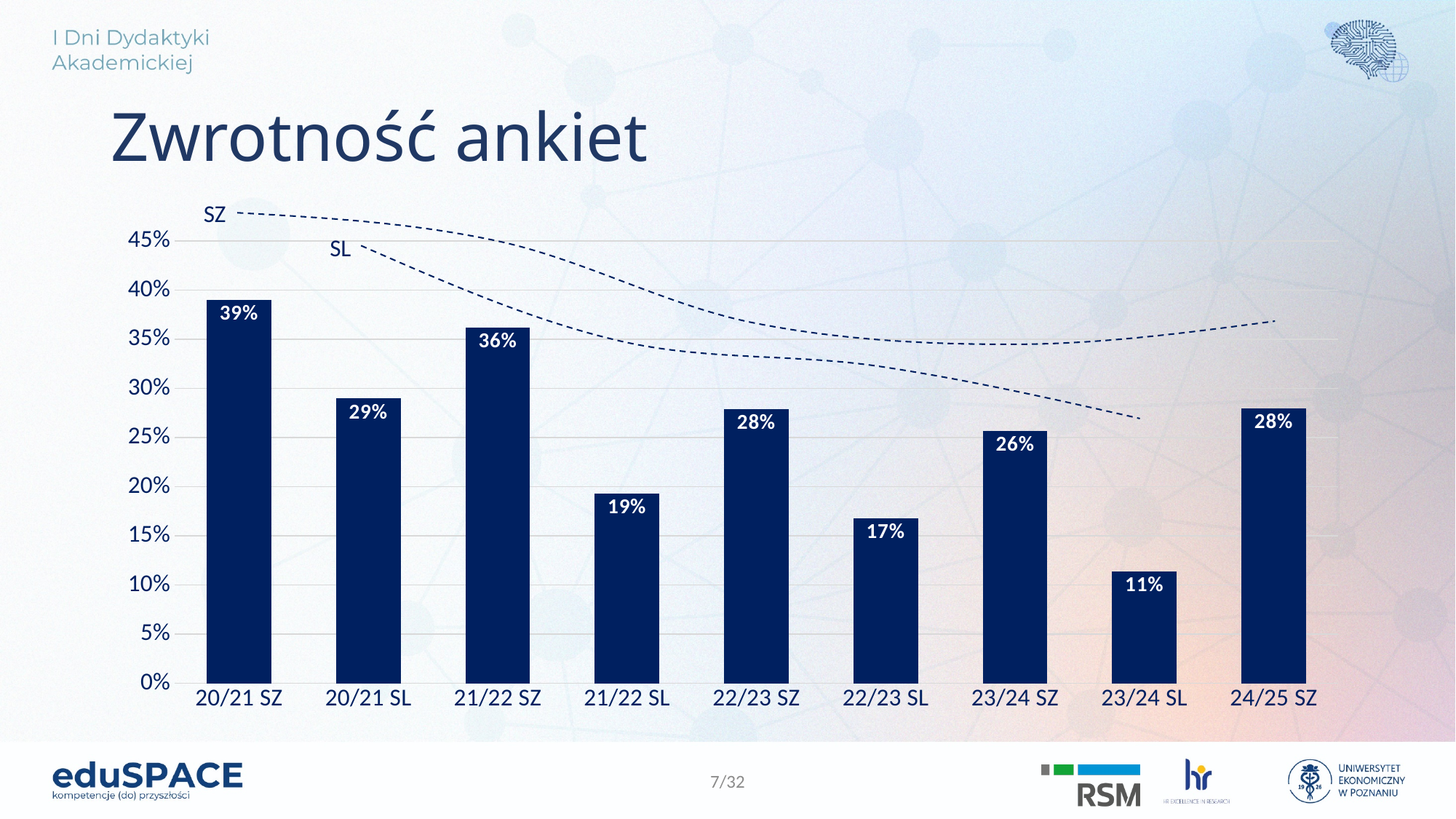
Do the values for the SZ categories rise or fall from 20/21 SZ to 23/24 SZ? fall What is the title of the chart? Zwrotność ankiet Which category has the lowest value? 23/24 SL Which category has the highest value? 20/21 SZ What is the value for 20/21 SZ? 39% How many categories are shown on the x axis? 9 Is the value for 22/23 SL greater or less than 20%? less What is the difference between the values for 21/22 SZ and 21/22 SL? 17% What is the value for 22/23 SZ? 28% What kind of chart is shown on the slide? bar chart What is the value for 23/24 SL? 11% Which is larger, the value for 20/21 SL or the value for 23/24 SZ? 20/21 SL